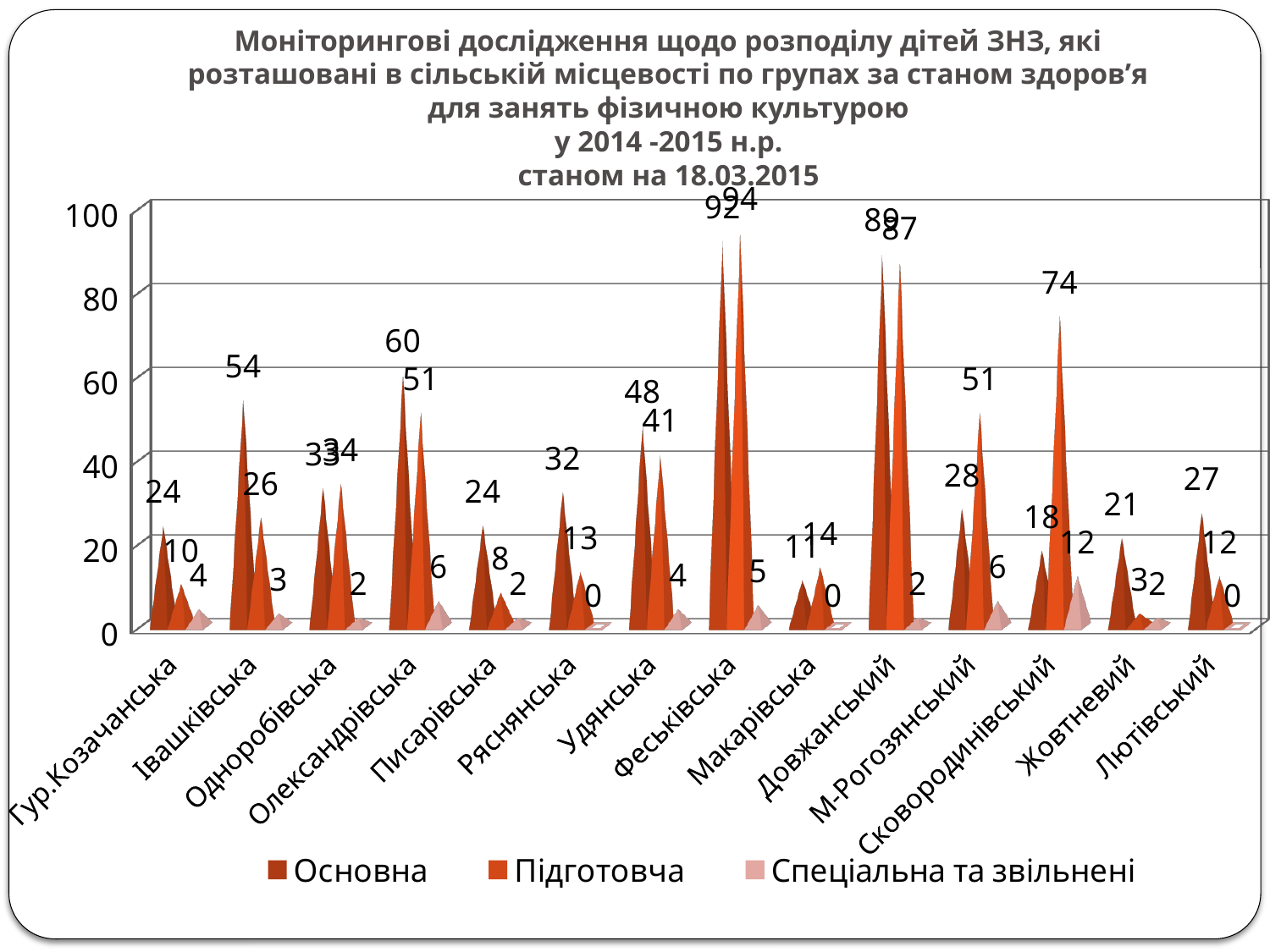
How many series does the legend list? 3 What is the value of Основна for Олександрівська? 60 Which category has the highest value for Спеціальна та звільнені? Сковородинівський How many categories are shown on the x axis? 14 Which category has the lowest value for Основна? Макарівська What kind of chart is shown on the slide? Bar chart What is the third series listed in the legend? Спеціальна та звільнені What is the difference between the Основна values for Івашківська and Писарівська? 30 What is the value of Підготовча for Сковородинівський? 74 Which category has the highest value for Підготовча? Феськівська Which is larger for М-Рогозянський: Основна or Підготовча? Підготовча What is the value of Спеціальна та звільнені for Гур.Козачанська? 4